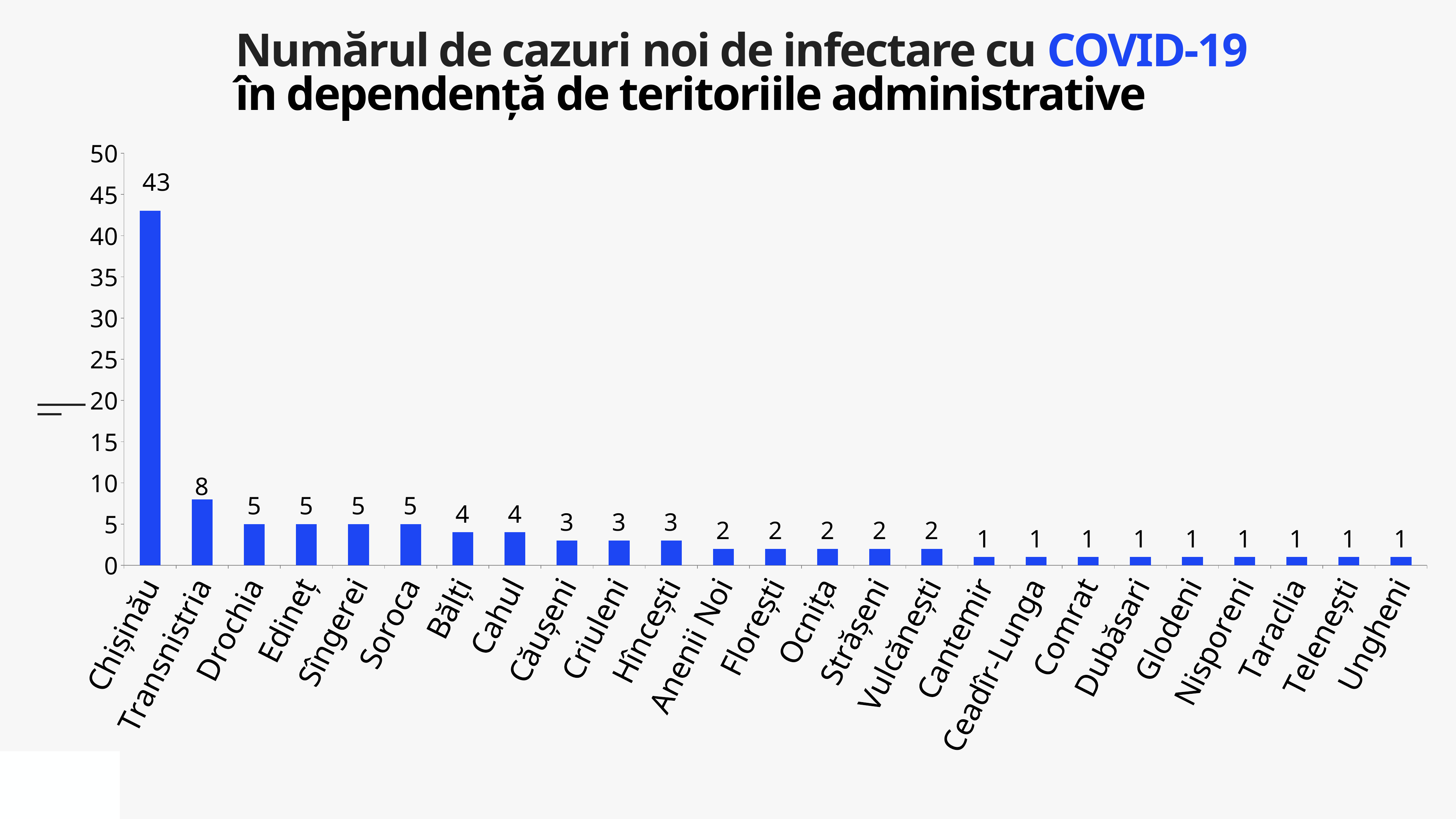
What is the value for Chișinău? 43 Which category has the highest value? Chișinău Which is larger, the value for Transnistria or the value for Soroca? Transnistria How many categories are shown on the x axis? 25 What is the difference between the values for Chișinău and Transnistria? 35 What is the value for Bălți? 4 What is the value for Transnistria? 8 What kind of chart is shown on the slide? bar chart Is the value for Chișinău greater or less than 40? greater What is the difference between the values for Drochia and Cahul? 1 What is the value for Hîncești? 3 What is the value for Ocnița? 2